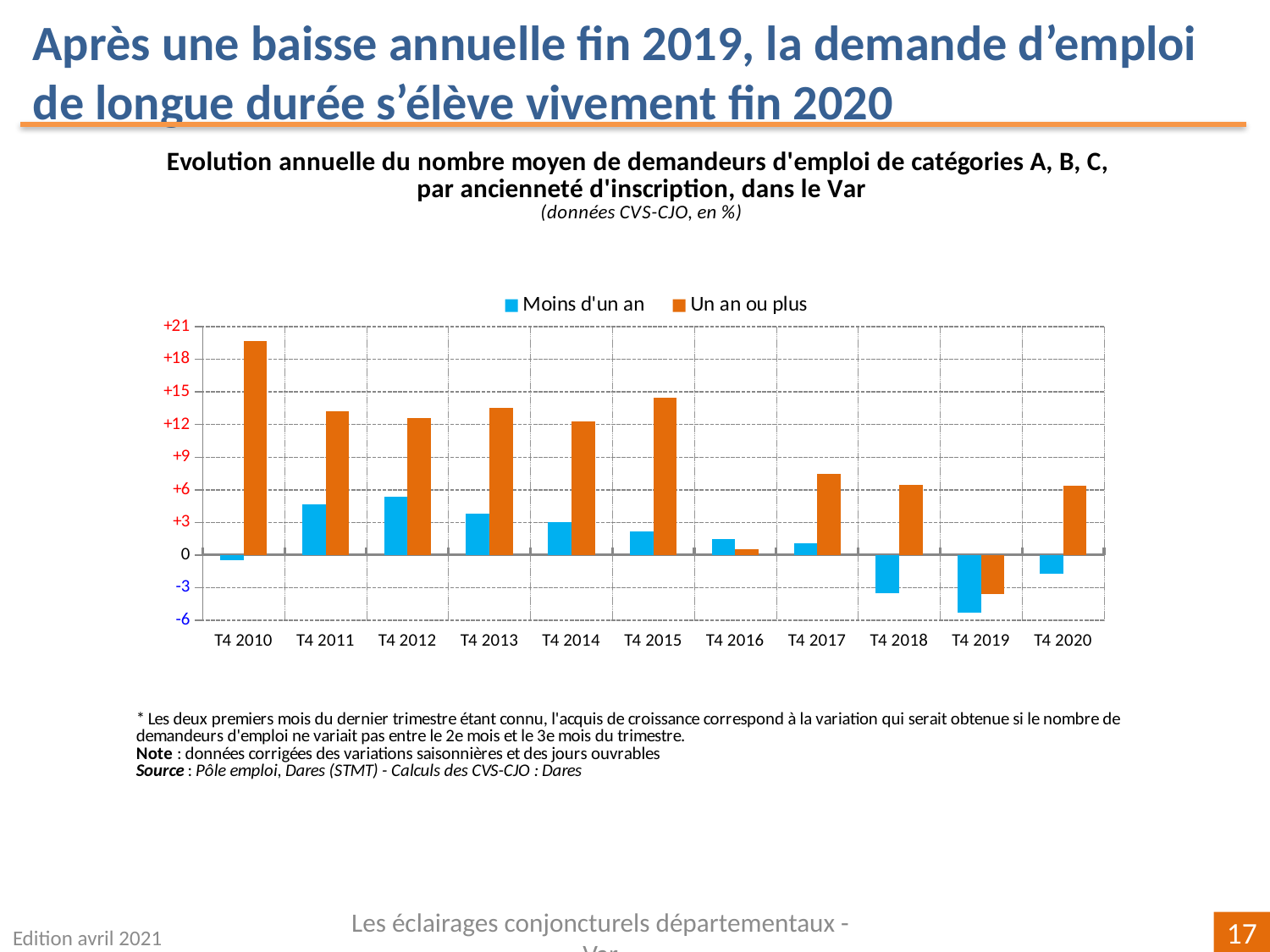
How many quarters (categories) are shown on the x axis? 11 Is the value for 'Moins d'un an' in T4 2019 greater or less than -3? less In which quarter is the value for 'Moins d'un an' the lowest? T4 2019 What kind of chart is shown on the slide? bar chart For the series 'Un an ou plus', which is larger: the value in T4 2014 or in T4 2015? T4 2015 In which quarter is the value for 'Un an ou plus' the highest? T4 2010 What colour represents the series 'Un an ou plus' in the chart? orange Is the value for 'Un an ou plus' in T4 2019 greater or less than 0? less Is the value for 'Un an ou plus' in T4 2010 greater or less than +18? greater How many series does the legend list? 2 In T4 2016, which series has the larger value, 'Moins d'un an' or 'Un an ou plus'? Moins d'un an